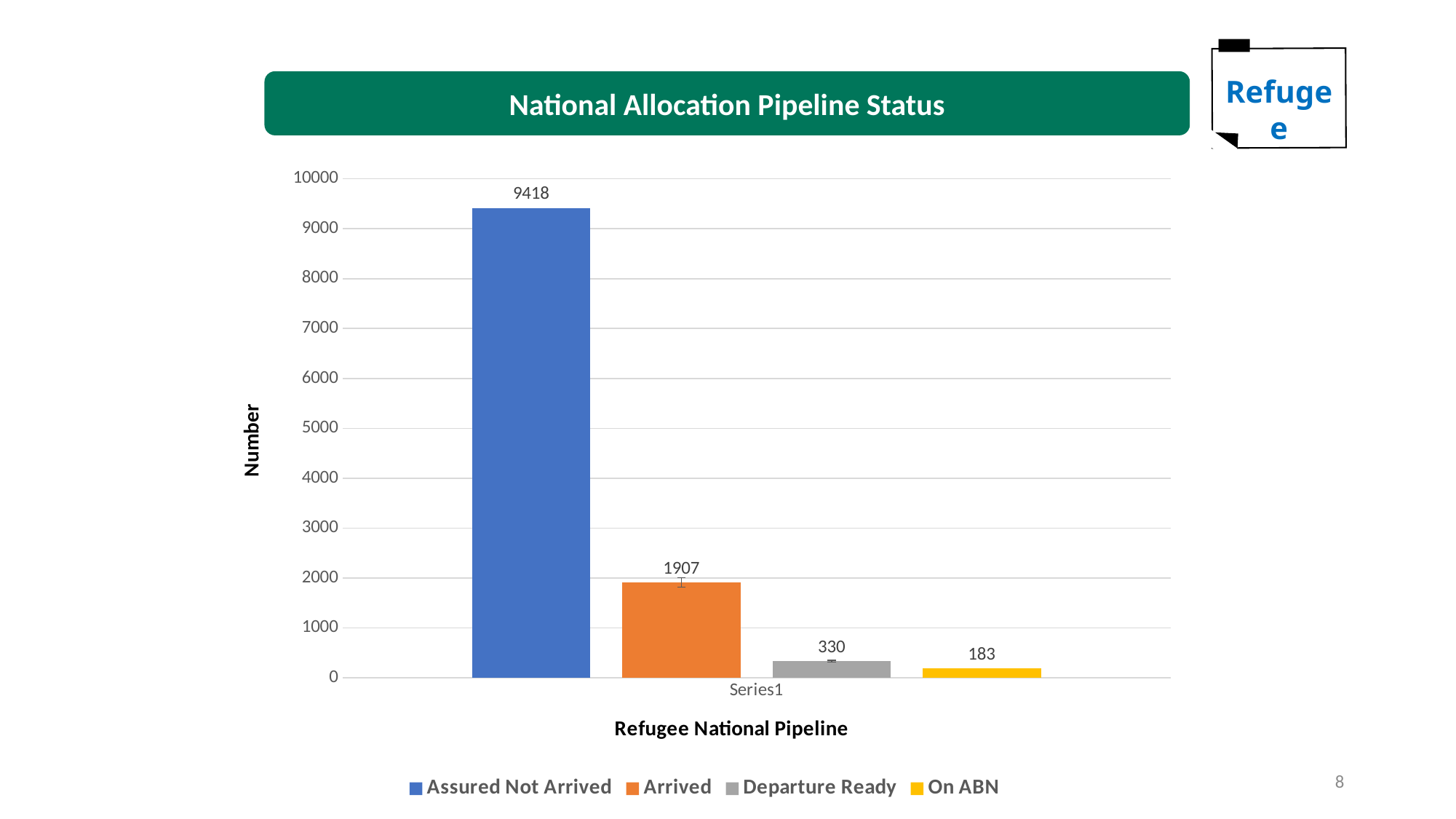
What kind of chart is shown on the slide? Bar chart Which series has the lowest value? On ABN What is the difference between the Assured Not Arrived and Arrived values? 7511 What is the value for Arrived? 1907 How many series does the legend list? 4 Which is larger, the value for Arrived or the value for Departure Ready? Arrived What is the value for On ABN? 183 What is the title of the chart? National Allocation Pipeline Status What is the value for Departure Ready? 330 Which series has the highest value? Assured Not Arrived What is the difference between the Departure Ready and On ABN values? 147 What is the value for Assured Not Arrived? 9418